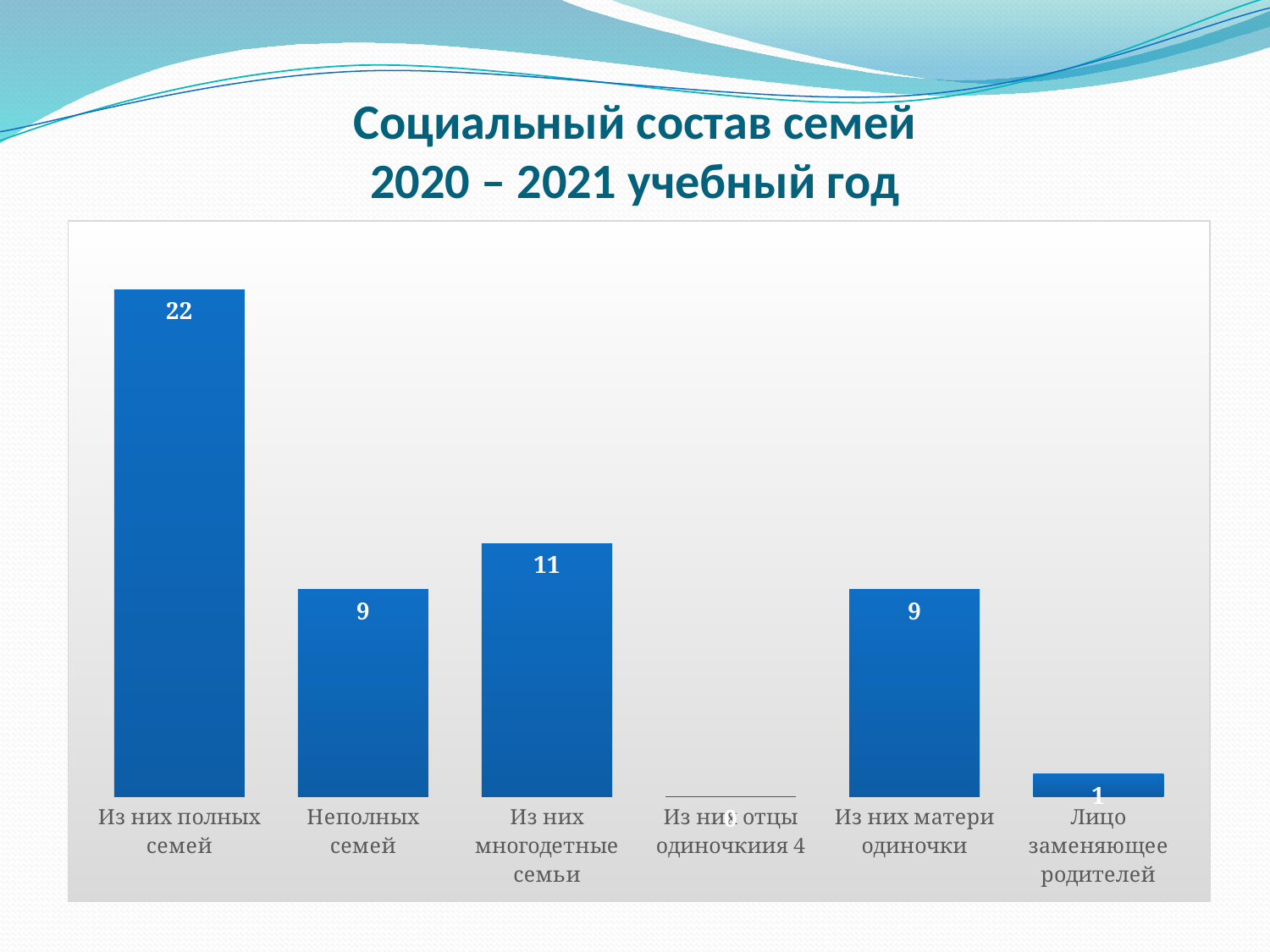
What is the value for "Лицо заменяющее родителей"? 1 What is the value for "Из них полных семей"? 22 What is the difference between the values for "Из них многодетные семьи" and "Из них матери одиночки"? 2 Which category has the highest value? Из них полных семей What kind of chart is shown on the slide? Bar chart What is the value for "Неполных семей"? 9 What is the value for "Из них матери одиночки"? 9 What is the difference between the values for "Из них полных семей" and "Неполных семей"? 13 Which is larger: the value for "Из них многодетные семьи" or for "Неполных семей"? Из них многодетные семьи What is the value for "Из них многодетные семьи"? 11 How many categories are shown on the x axis? 6 What is the title of the slide? Социальный состав семей 2020 – 2021 учебный год